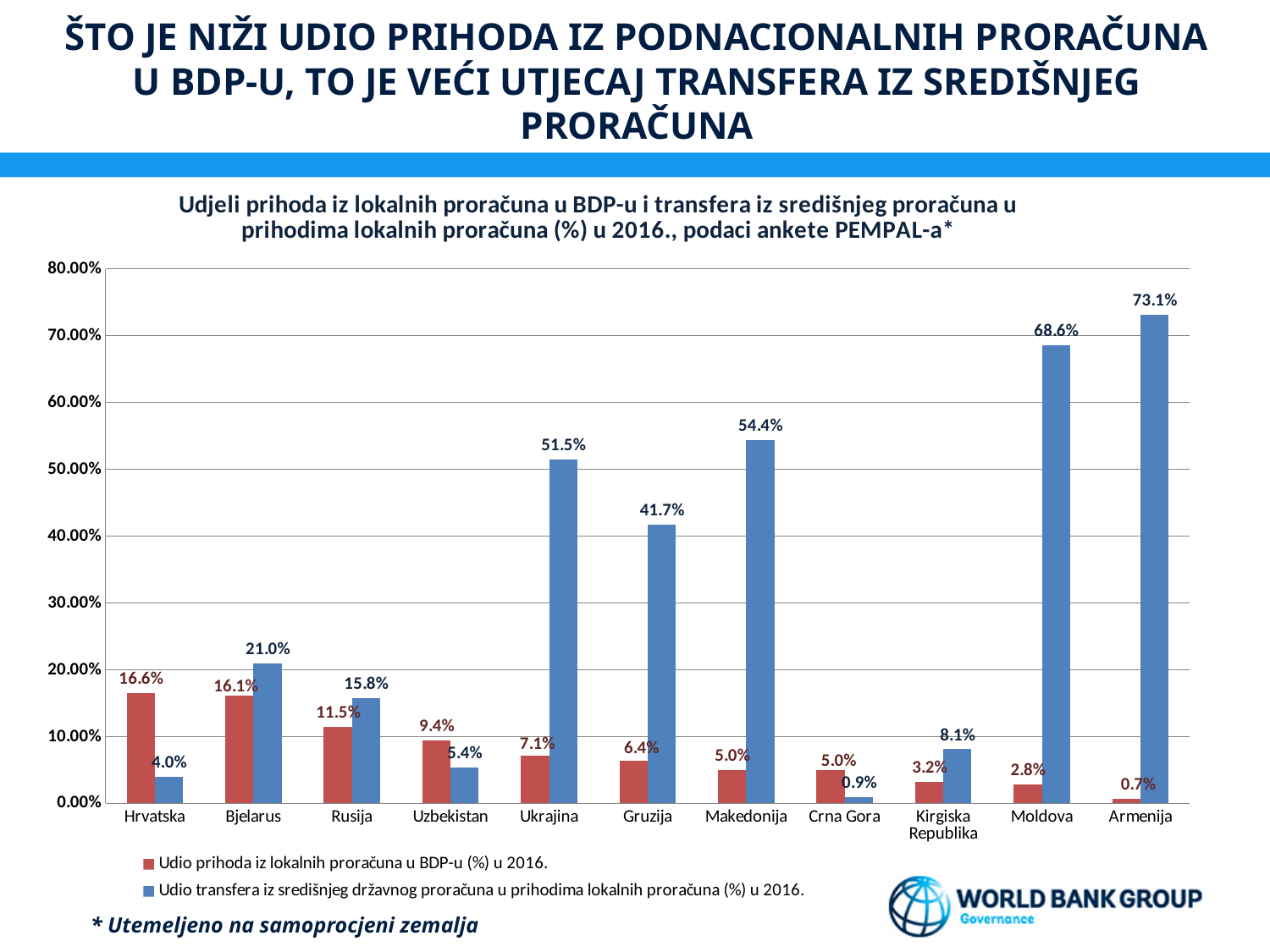
Which country has the lowest value in the blue series (transfers from the central budget)? Crna Gora What is the share of local budget revenues in GDP (red series) for Hrvatska? 16.6% What is the value of the blue series (transfers from the central budget) for Ukrajina? 51.5% Which country has the highest share of transfers from the central budget in local budget revenues (blue series)? Armenija What is the share of transfers from the central budget in local budget revenues (blue series) for Armenija? 73.1% Is the blue series value for Makedonija greater or less than 50.00%? greater What is the difference between the blue and red values for Moldova? 65.8% How many countries are shown on the x axis of the chart? 11 For Uzbekistan, which is larger: the red series (local revenues in GDP) or the blue series (transfers from the central budget)? Red series (local revenues in GDP) How many series does the chart's legend list? 2 What type of chart is shown on the slide? Bar chart Which country has the lowest share of local budget revenues in GDP (red series)? Armenija